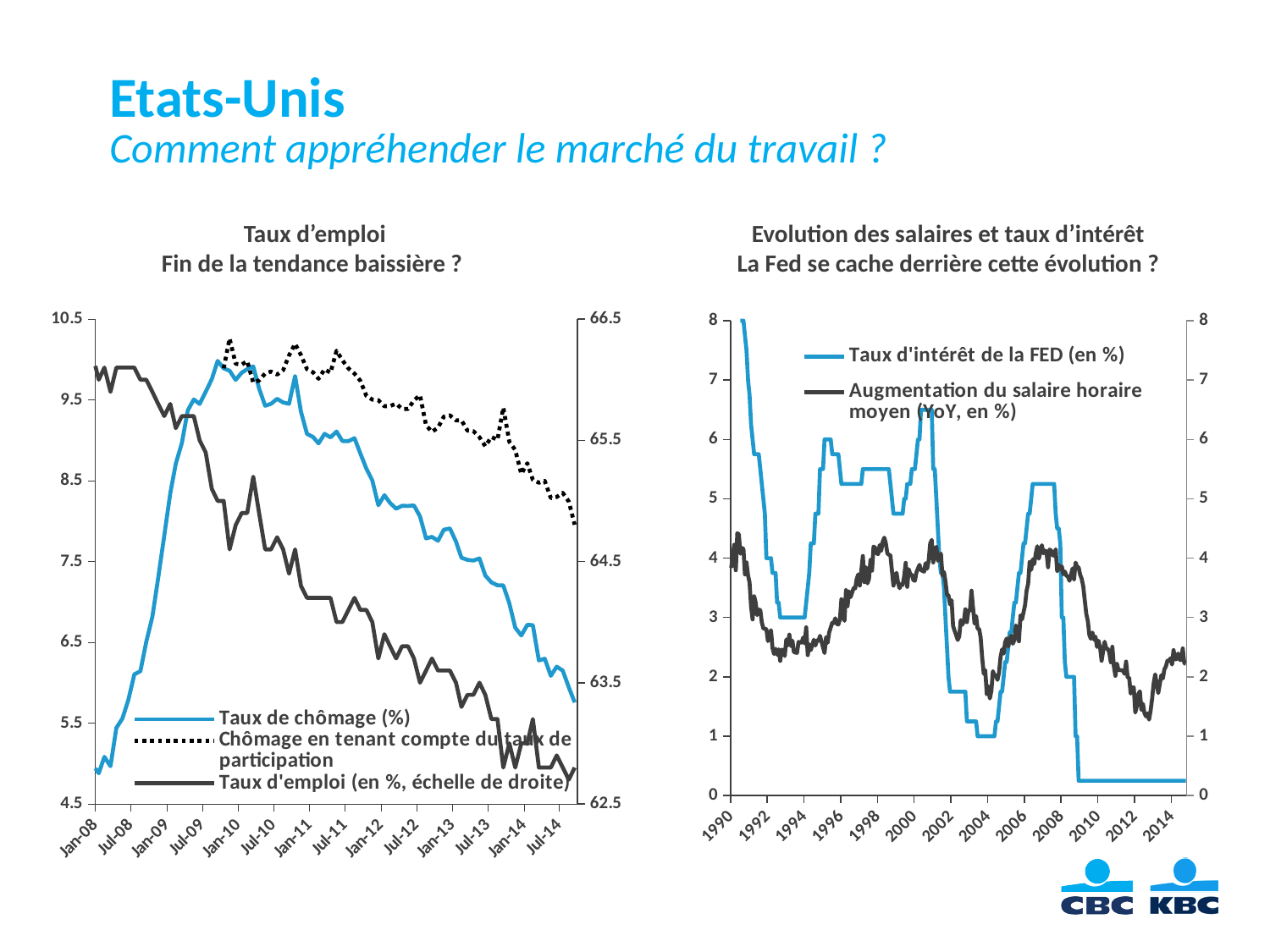
In the right chart 'Evolution des salaires et taux d'intérêt', is the value of 'Taux d'intérêt de la FED (en %)' in 2007 greater or less than 5? greater In the left chart 'Taux d'emploi', which series is plotted on the right-hand axis? Taux d'emploi (en %, échelle de droite) What kind of chart is the left chart titled 'Taux d'emploi'? line chart In the left chart 'Taux d'emploi', does the 'Taux d'emploi (en %, échelle de droite)' series rise or fall overall from Jan-08 to Jul-14? fall In the right chart 'Evolution des salaires et taux d'intérêt', is the value of 'Taux d'intérêt de la FED (en %)' at the start of 1990 greater or less than 7? greater In the right chart 'Evolution des salaires et taux d'intérêt', which series is drawn in blue? Taux d'intérêt de la FED (en %) In the right chart 'Evolution des salaires et taux d'intérêt', how many series does the legend list? 2 In the left chart 'Taux d'emploi', how many series does the legend list? 3 In the right chart 'Evolution des salaires et taux d'intérêt', is the value of 'Taux d'intérêt de la FED (en %)' in 2012 greater or less than 1? less What kind of chart is the right chart titled 'Evolution des salaires et taux d'intérêt'? line chart